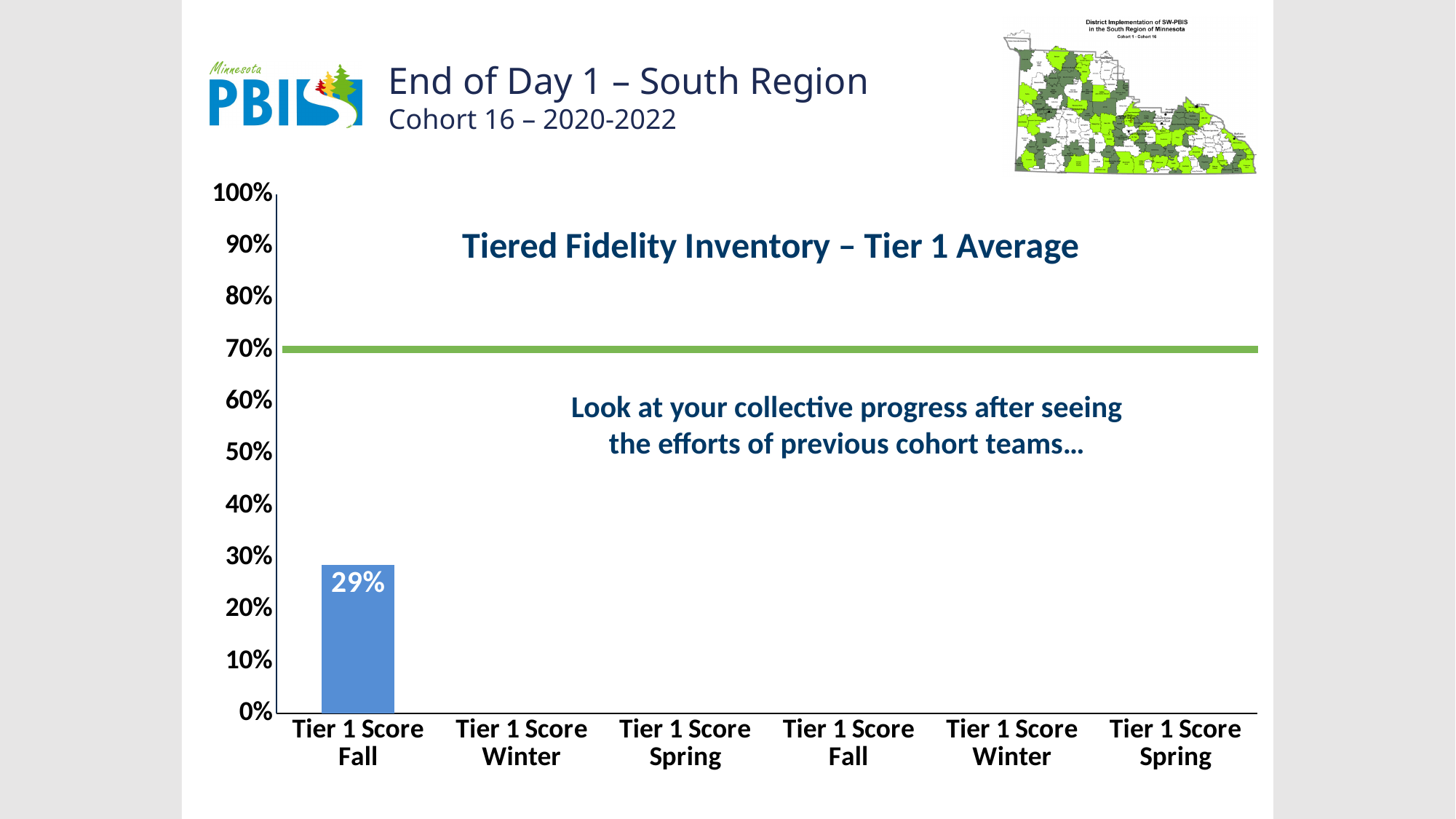
How many bars actually have a plotted value in the chart? 1 Is the value for the first Tier 1 Score Fall bar greater or less than 30%? less What is the label of the category that has a plotted bar? Tier 1 Score Fall What kind of chart is shown on the slide? bar chart Is the value for the first Tier 1 Score Fall bar greater or less than 20%? greater At what percentage level is the green horizontal line drawn across the chart? 70% How many categories are listed along the x axis of the chart? 6 What is the title of the chart? Tiered Fidelity Inventory – Tier 1 Average Is the first Tier 1 Score Fall bar above or below the green 70% line? below What is the highest value shown on the y axis of the chart? 100% What is the value of the first Tier 1 Score Fall bar? 29%